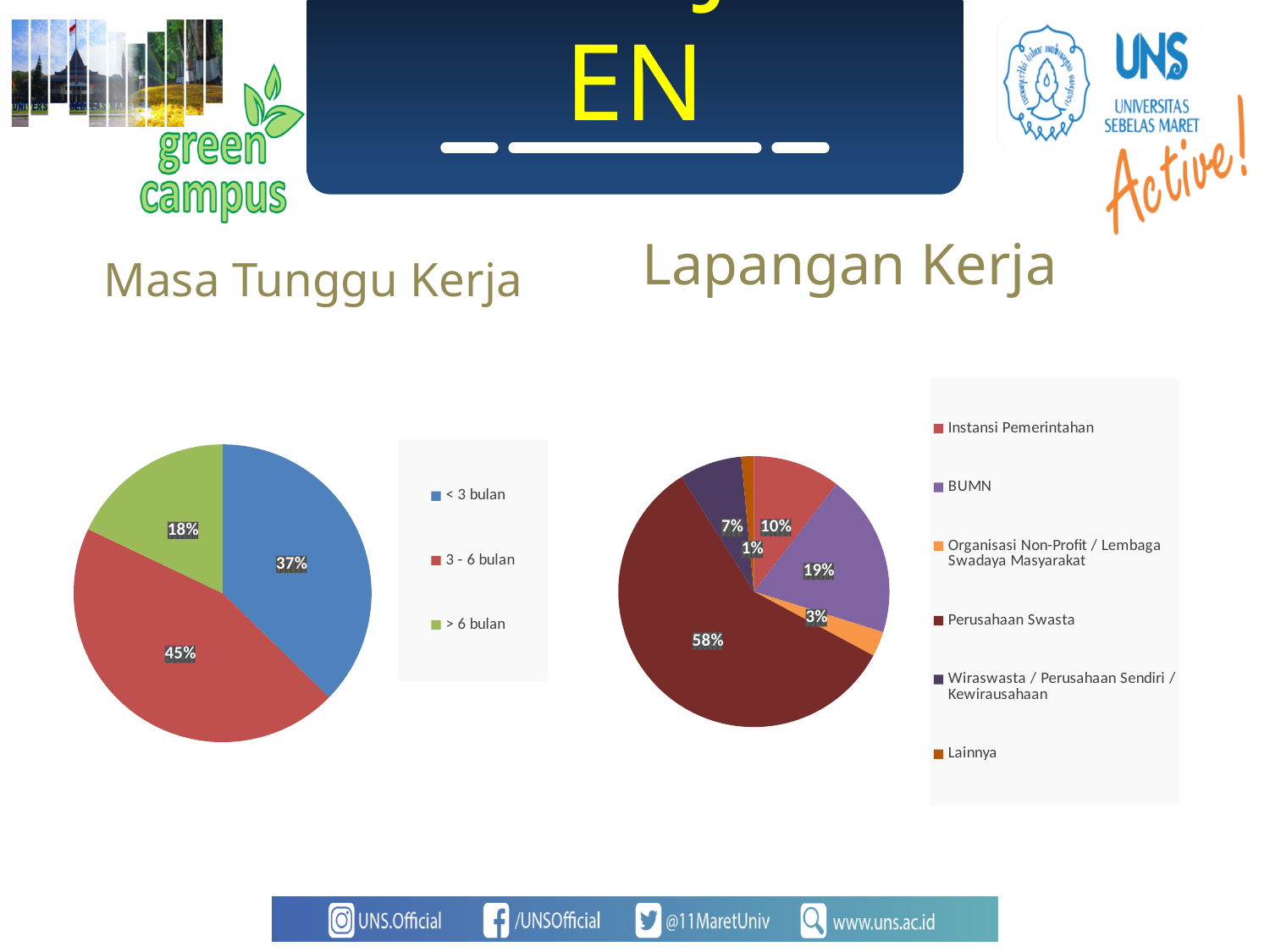
In the Masa Tunggu Kerja chart, which category has the smallest slice? > 6 bulan In the Masa Tunggu Kerja chart, what is the difference in percentage points between '3 - 6 bulan' and '> 6 bulan'? 27 In the Masa Tunggu Kerja chart, what share is labelled for '< 3 bulan'? 37% In the Lapangan Kerja chart, what colour is the 'Perusahaan Swasta' slice? Dark red In the Masa Tunggu Kerja chart, what share is labelled for '3 - 6 bulan'? 45% In the Lapangan Kerja chart, how many categories does the legend list? 6 What kind of chart is the Masa Tunggu Kerja chart? Pie chart In the Lapangan Kerja chart, which category has the smallest slice? Lainnya In the Lapangan Kerja chart, what share is labelled for 'Perusahaan Swasta'? 58% In the Masa Tunggu Kerja chart, how many categories does the legend list? 3 In the Lapangan Kerja chart, what share is labelled for 'BUMN'? 19% In the Lapangan Kerja chart, which is larger: 'Instansi Pemerintahan' or 'Wiraswasta / Perusahaan Sendiri / Kewirausahaan'? Instansi Pemerintahan